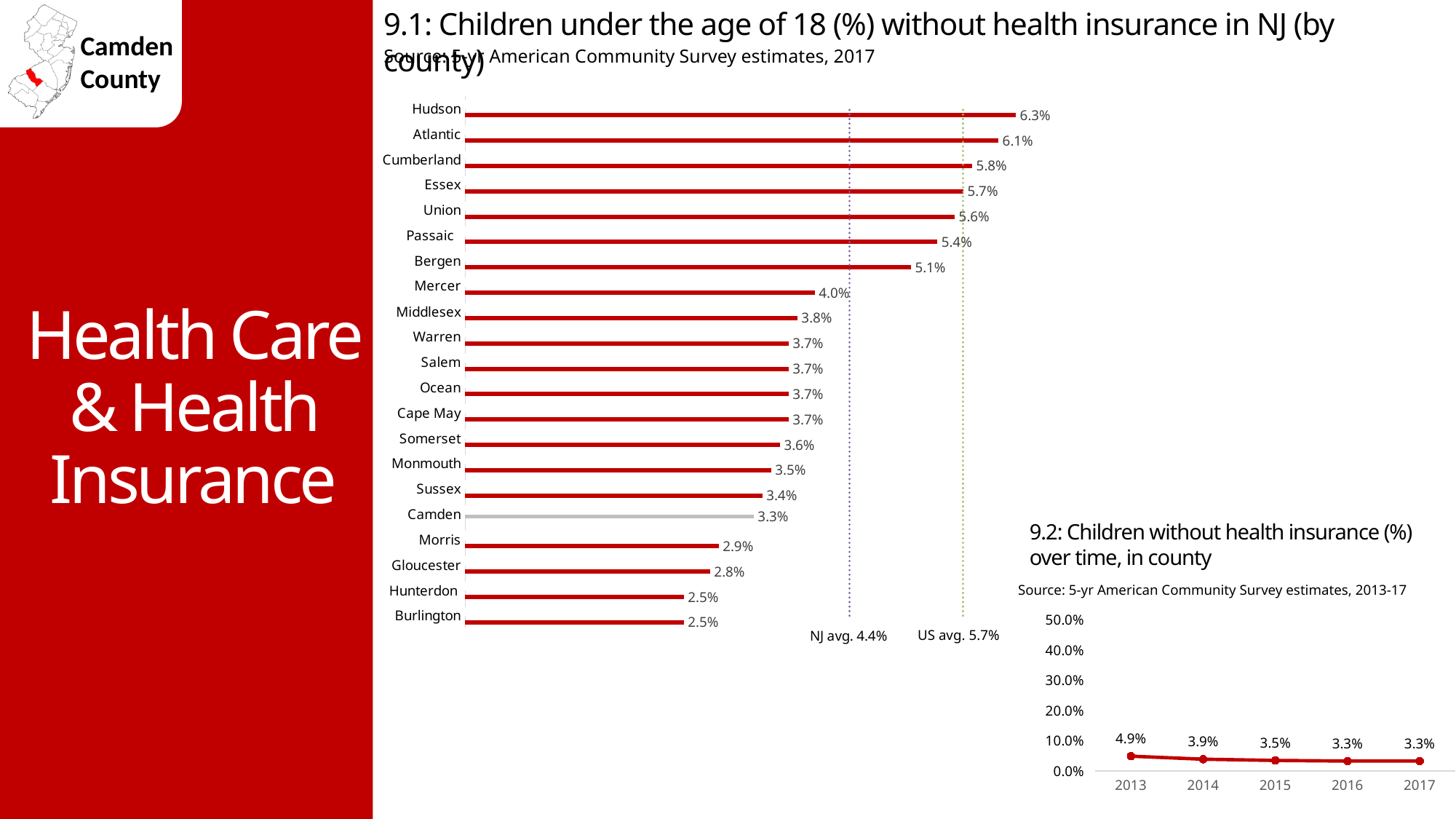
In chart 9.1, which county has the highest percentage of children without health insurance? Hudson In chart 9.1, what is the value for Bergen? 5.1% What kind of chart is chart 9.2? Line chart In chart 9.1, what is the NJ average shown by the dotted reference line? 4.4% In chart 9.2, do the values rise or fall from 2013 to 2017? Fall In chart 9.2 (children without health insurance over time), what is the value for 2013? 4.9% In chart 9.1 (children under 18 without health insurance by county), what is the value for Camden? 3.3% In chart 9.2, what is the difference between the 2013 value and the 2017 value? 1.6% In chart 9.1, what is the difference between Hudson and Camden? 3.0% What kind of chart is chart 9.1? Bar chart In chart 9.1, how many counties are plotted? 21 In chart 9.1, which is larger, the value for Passaic or the value for Mercer? Passaic